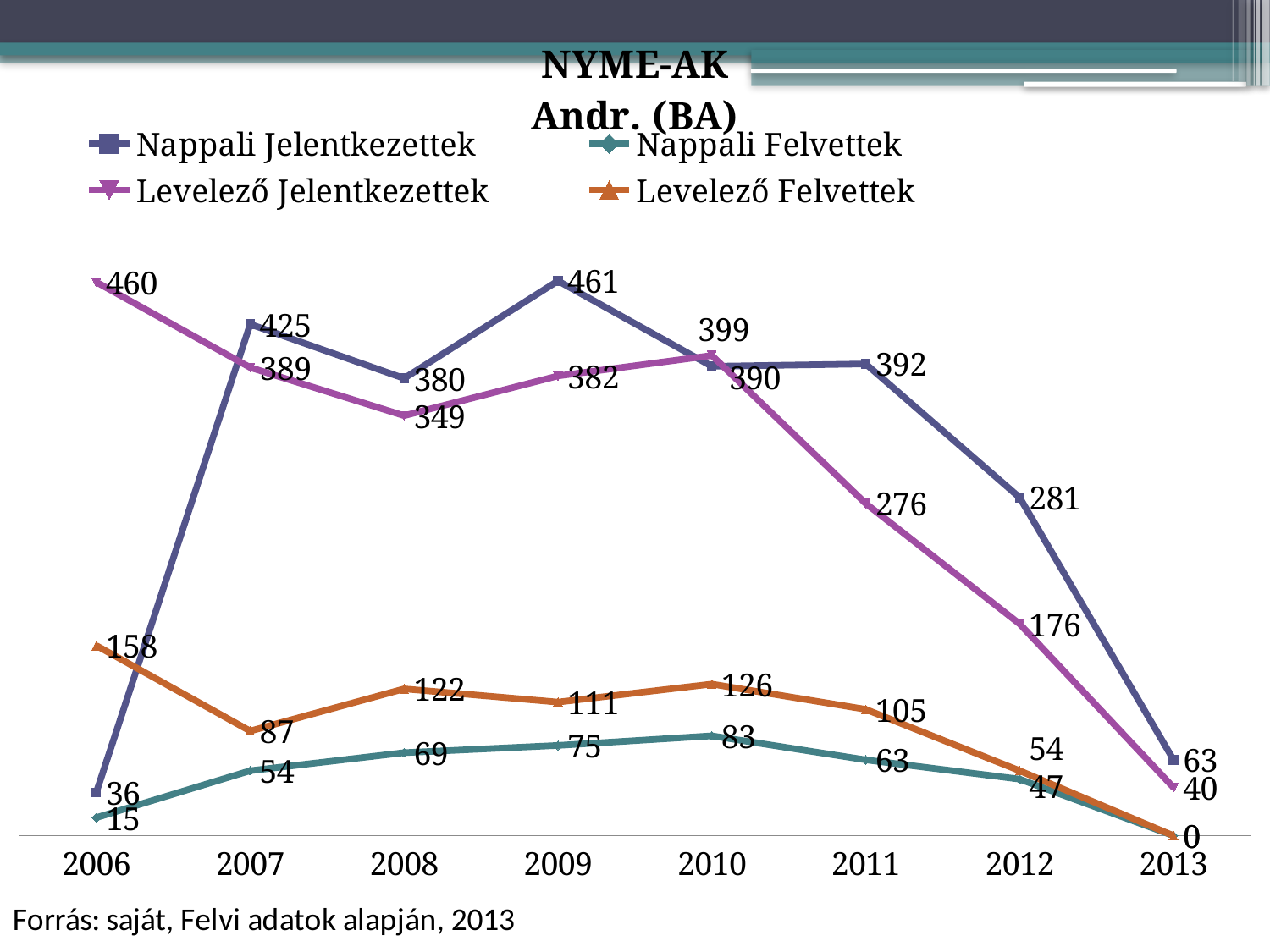
Does Levelező Jelentkezettek rise or fall from 2010 to 2013? fall In which year is Levelező Jelentkezettek at its lowest? 2013 What is the value for Nappali Jelentkezettek in 2009? 461 What kind of chart is shown on the slide? line chart What is the value for Levelező Jelentkezettek in 2006? 460 What is the value for Levelező Felvettek in 2010? 126 What is the value for Nappali Felvettek in 2008? 69 How many series does the legend list? 4 In 2010, which is larger: Nappali Jelentkezettek or Levelező Jelentkezettek? Levelező Jelentkezettek By how much did Nappali Jelentkezettek increase from 2006 to 2007? 389 How many years are shown on the x axis? 8 In which year is Nappali Jelentkezettek at its highest? 2009